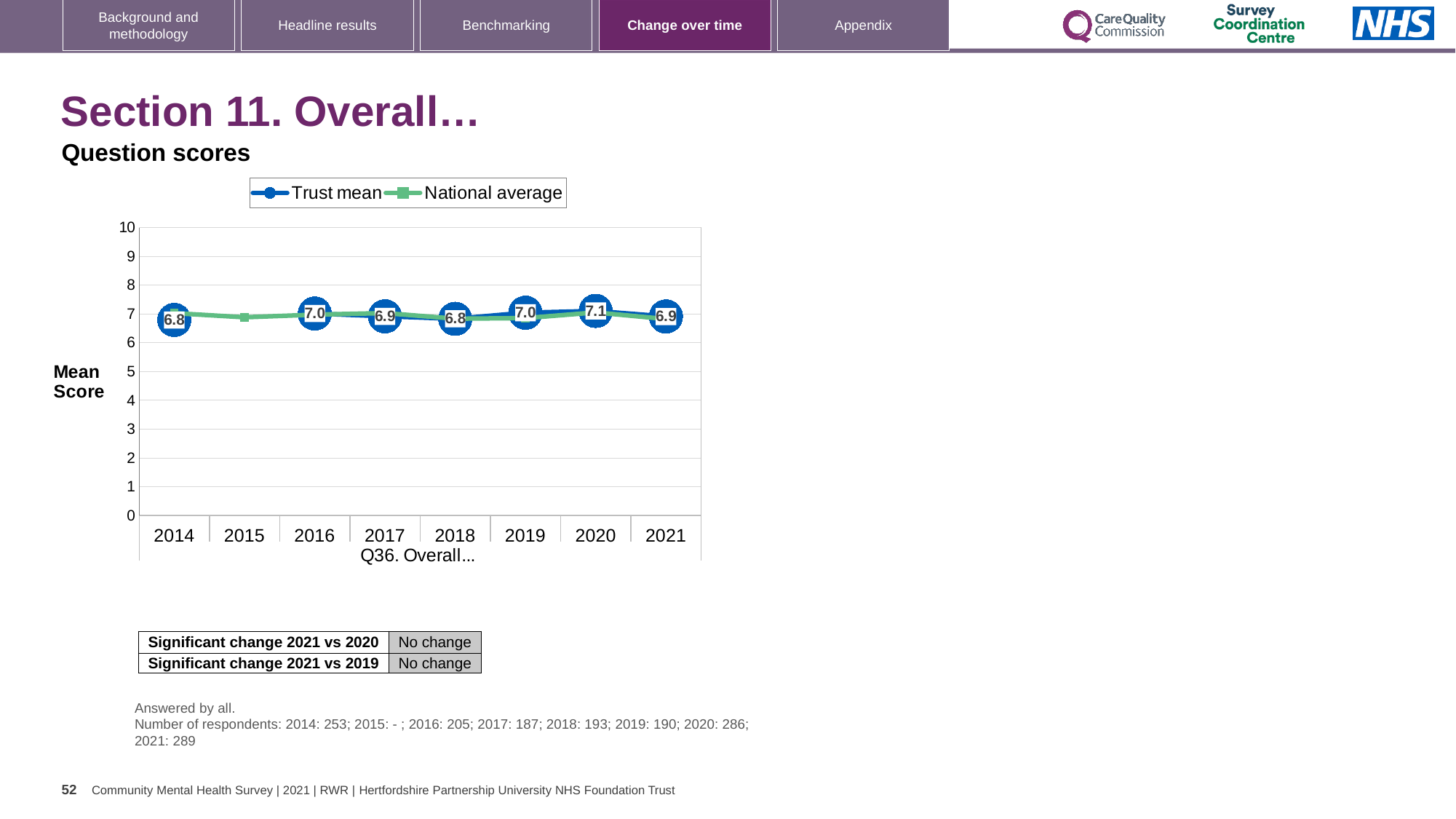
What is the Trust mean value for 2021? 6.9 How many series does the legend list? 2 How many years are shown on the x axis? 8 What is the difference between the Trust mean in 2020 and in 2014? 0.3 What is the Trust mean value for 2014? 6.8 Is the Trust mean value for 2019 greater or less than 8? less What is the label on the y axis of the chart? Mean Score What is the Trust mean value for 2020? 7.1 What is the Trust mean value for 2017? 6.9 Which year has the larger Trust mean, 2020 or 2021? 2020 In which year is the Trust mean highest? 2020 What kind of chart is shown on the slide? Line chart